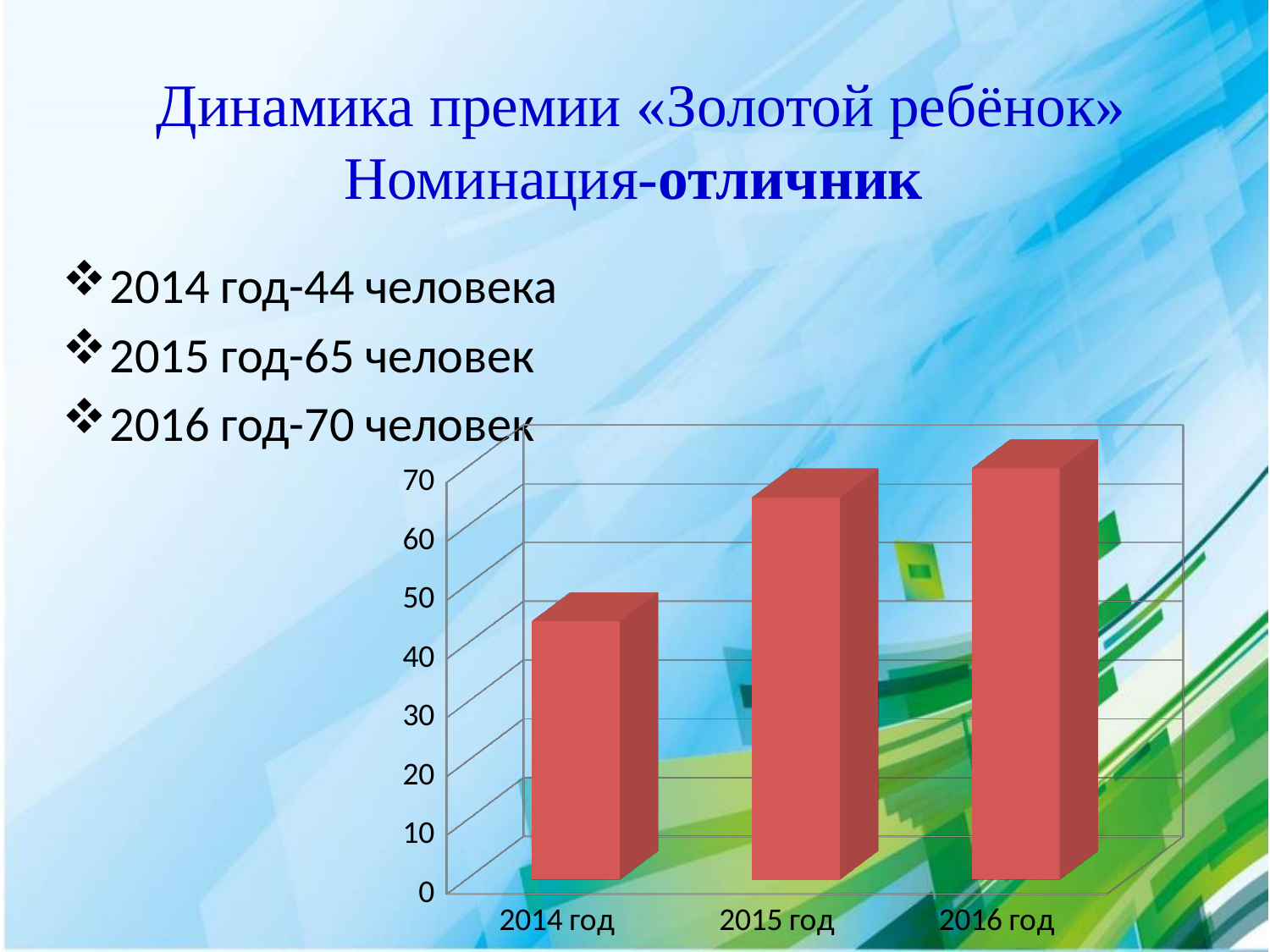
What is the highest tick value shown on the chart's vertical axis? 70 By how much did the number of people increase from 2014 год to 2016 год, according to the values on the slide? 26 What kind of chart is shown on the slide? bar chart According to the slide, how many people received the award in 2015 год? 65 How many categories (years) are shown on the chart's x axis? 3 Is the value for 2014 год greater or less than 50? less Which year has the lowest bar on the chart? 2014 год Is the value for 2014 год greater or less than 40? greater Which year has the highest bar on the chart? 2016 год According to the slide, how many people received the award in 2014 год? 44 Do the values rise or fall from 2014 год to 2016 год along the x axis? rise Is the value for 2015 год greater or less than 60? greater